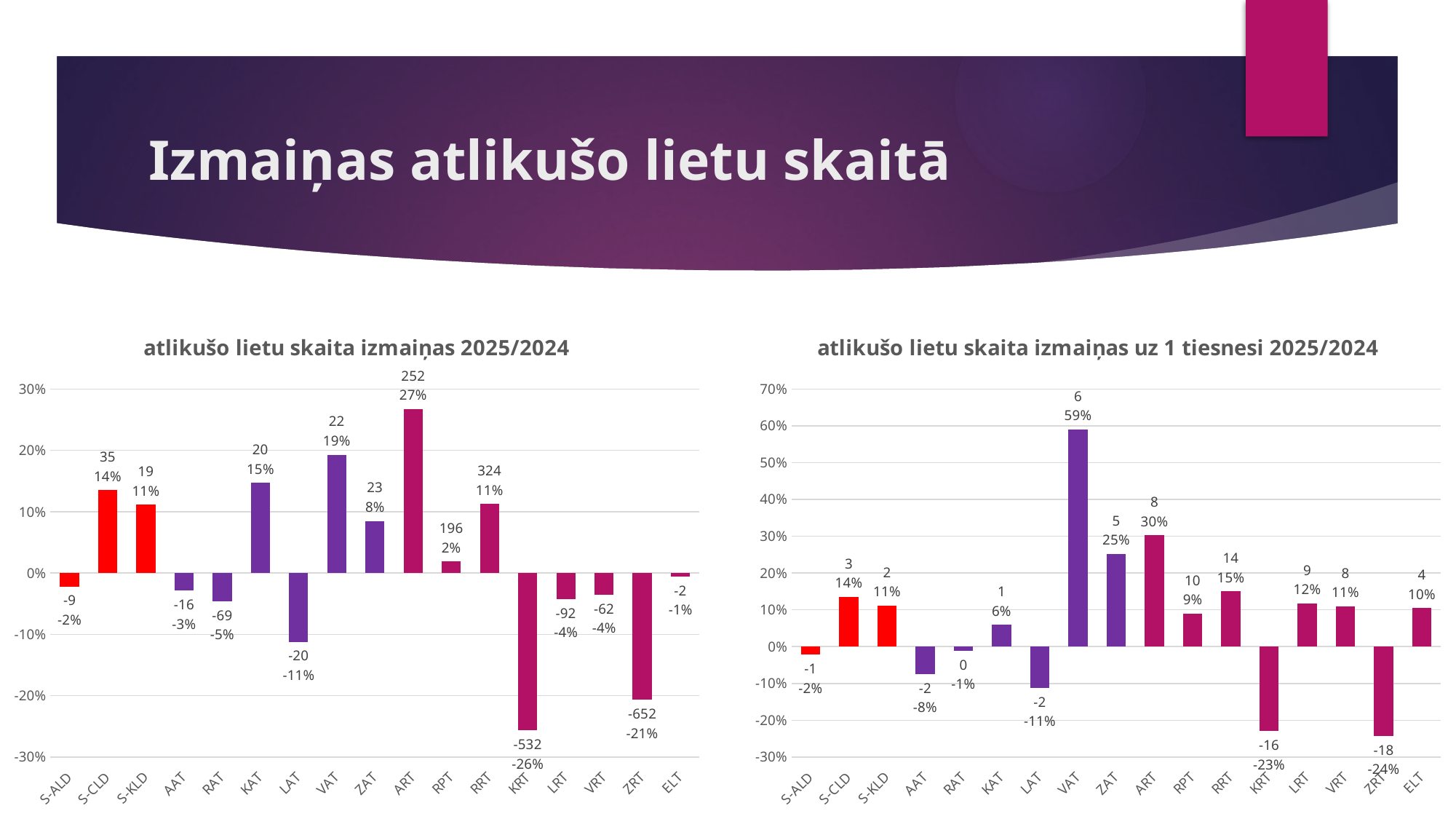
In the chart 'atlikušo lietu skaita izmaiņas 2025/2024', which category has the lowest percentage change? KRT In the chart 'atlikušo lietu skaita izmaiņas 2025/2024', which category has the highest percentage change? ART In the chart 'atlikušo lietu skaita izmaiņas uz 1 tiesnesi 2025/2024', which category has the highest percentage change? VAT In the chart 'atlikušo lietu skaita izmaiņas 2025/2024', what is the difference between the percentage values for S-CLD and S-KLD? 3% In the chart 'atlikušo lietu skaita izmaiņas uz 1 tiesnesi 2025/2024', what percentage change is shown for VAT? 59% What type of chart is the chart on the right of the slide? Bar chart In the chart 'atlikušo lietu skaita izmaiņas uz 1 tiesnesi 2025/2024', which is larger, the percentage for ZAT or the percentage for RRT? ZAT In the chart 'atlikušo lietu skaita izmaiņas 2025/2024', how many categories are shown on the x axis? 17 In the chart 'atlikušo lietu skaita izmaiņas 2025/2024', what percentage change is shown for ART? 27% In the chart 'atlikušo lietu skaita izmaiņas 2025/2024', what number is labelled above the bar for RRT? 324 In the chart 'atlikušo lietu skaita izmaiņas uz 1 tiesnesi 2025/2024', what number is labelled above the bar for KRT? -16 In the chart 'atlikušo lietu skaita izmaiņas uz 1 tiesnesi 2025/2024', which category has the lowest percentage change? ZRT